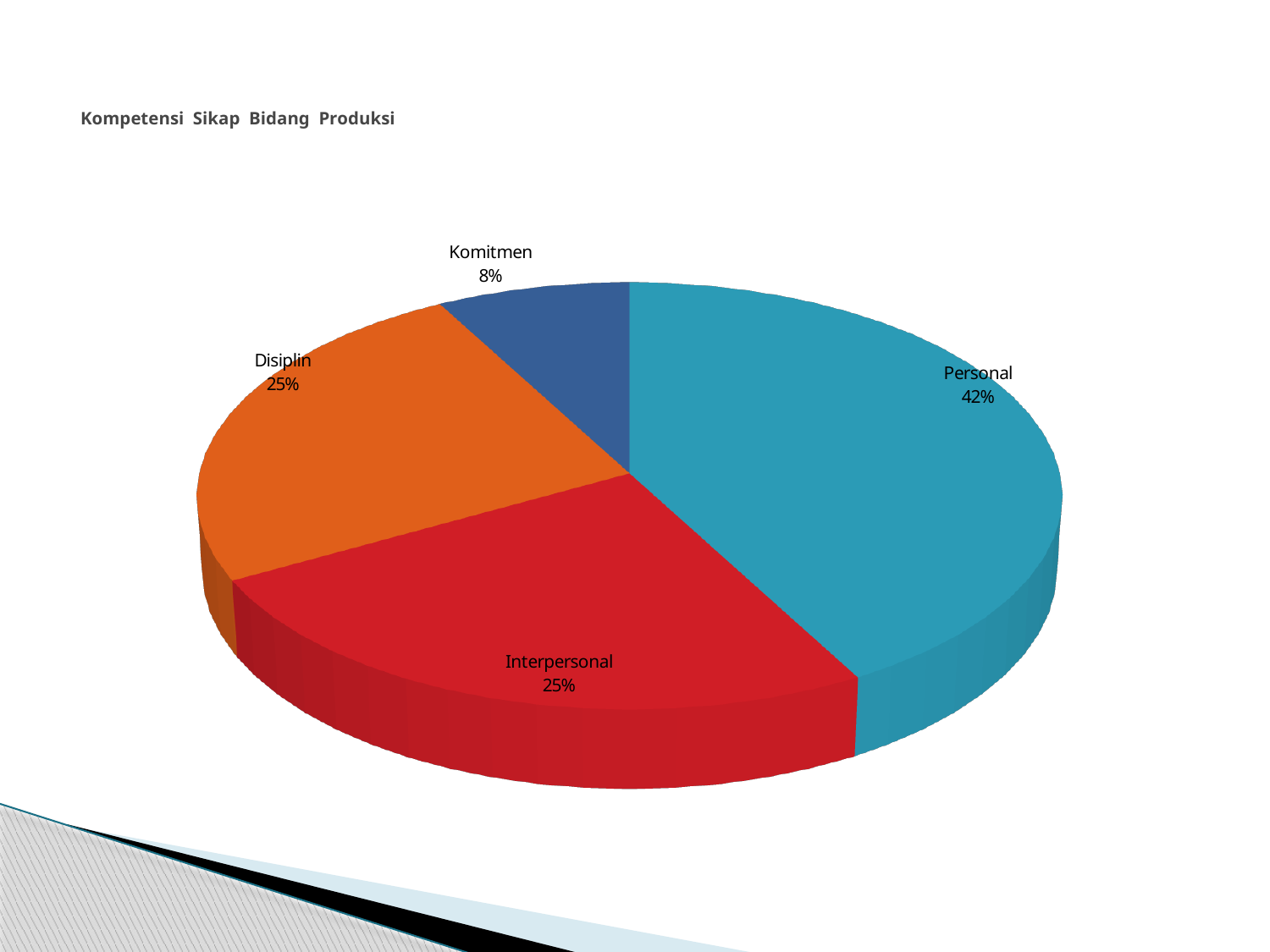
How many categories are shown in the pie chart? 4 What is the title of the slide? Kompetensi Sikap Bidang Produksi What share of the pie does Komitmen have? 8% Which is larger, the share for Personal or the share for Interpersonal? Personal What kind of chart is shown on the slide? Pie chart Which category has the smallest slice of the pie? Komitmen What share of the pie does Interpersonal have? 25% What share of the pie does Disiplin have? 25% What share of the pie does Personal have? 42% What is the difference in percentage points between Personal and Komitmen? 34 Which category has the largest slice of the pie? Personal What is the difference in percentage points between Personal and Disiplin? 17